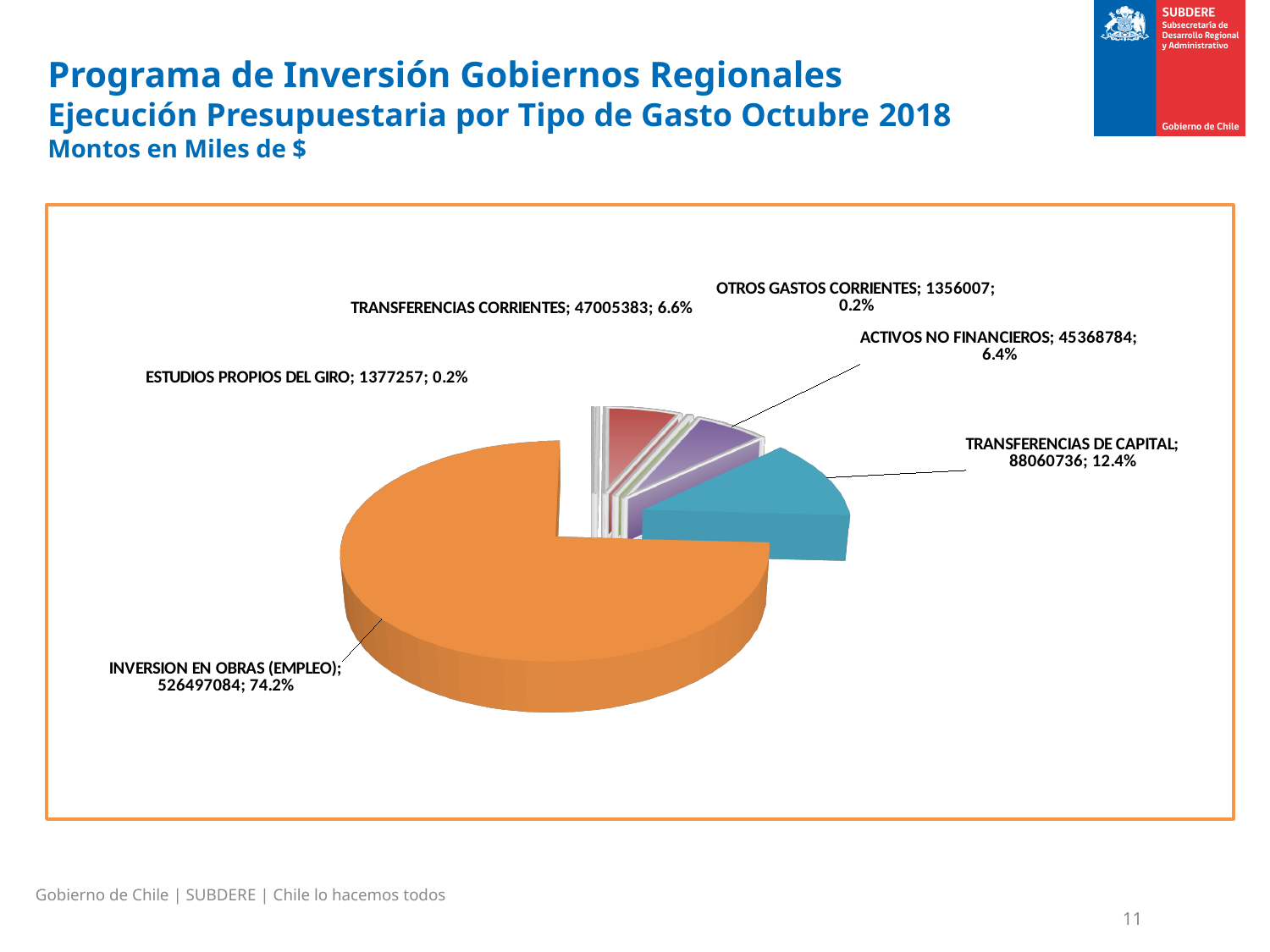
What is the value for INVERSION EN OBRAS (EMPLEO)? 526497084 What is the difference between the values for TRANSFERENCIAS DE CAPITAL and TRANSFERENCIAS CORRIENTES? 41055353 In what units are the amounts on the chart expressed, according to the slide subtitle? Miles de $ Which category has the smallest value? OTROS GASTOS CORRIENTES What share of the pie does INVERSION EN OBRAS (EMPLEO) represent? 74.2% Which category has the largest value? INVERSION EN OBRAS (EMPLEO) What kind of chart is shown on the slide? Pie chart What is the value for TRANSFERENCIAS DE CAPITAL? 88060736 What share of the pie does TRANSFERENCIAS CORRIENTES represent? 6.6% What is the value for ACTIVOS NO FINANCIEROS? 45368784 Which is larger, the value for TRANSFERENCIAS CORRIENTES or the value for ACTIVOS NO FINANCIEROS? TRANSFERENCIAS CORRIENTES How many categories does the pie chart show? 6